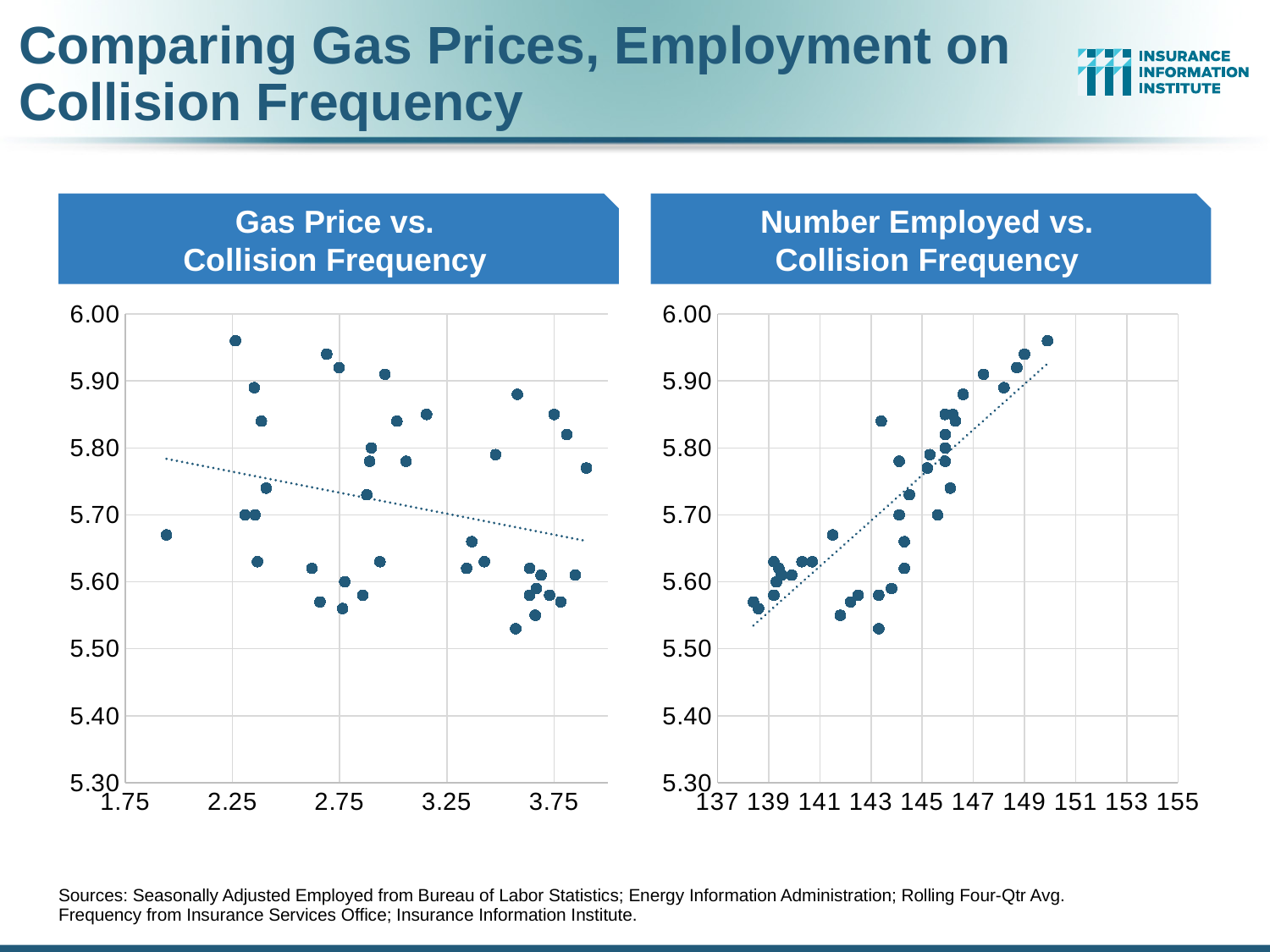
What is the highest value shown on the x axis of the 'Number Employed vs. Collision Frequency' chart? 155 In the 'Gas Price vs. Collision Frequency' chart, is the highest plotted collision frequency greater or less than 5.90? greater What kind of chart is the 'Number Employed vs. Collision Frequency' chart? scatter chart In the 'Gas Price vs. Collision Frequency' chart, is the lowest plotted collision frequency greater or less than 5.60? less What is the lowest value shown on the y axis of the 'Gas Price vs. Collision Frequency' chart? 5.30 In the 'Number Employed vs. Collision Frequency' chart, is the lowest plotted collision frequency greater or less than 5.60? less In the 'Gas Price vs. Collision Frequency' chart, does the dotted trend line rise or fall as gas price increases along the x axis? fall In the 'Number Employed vs. Collision Frequency' chart, does the dotted trend line rise or fall as the number employed increases along the x axis? rise What kind of chart is the 'Gas Price vs. Collision Frequency' chart? scatter chart